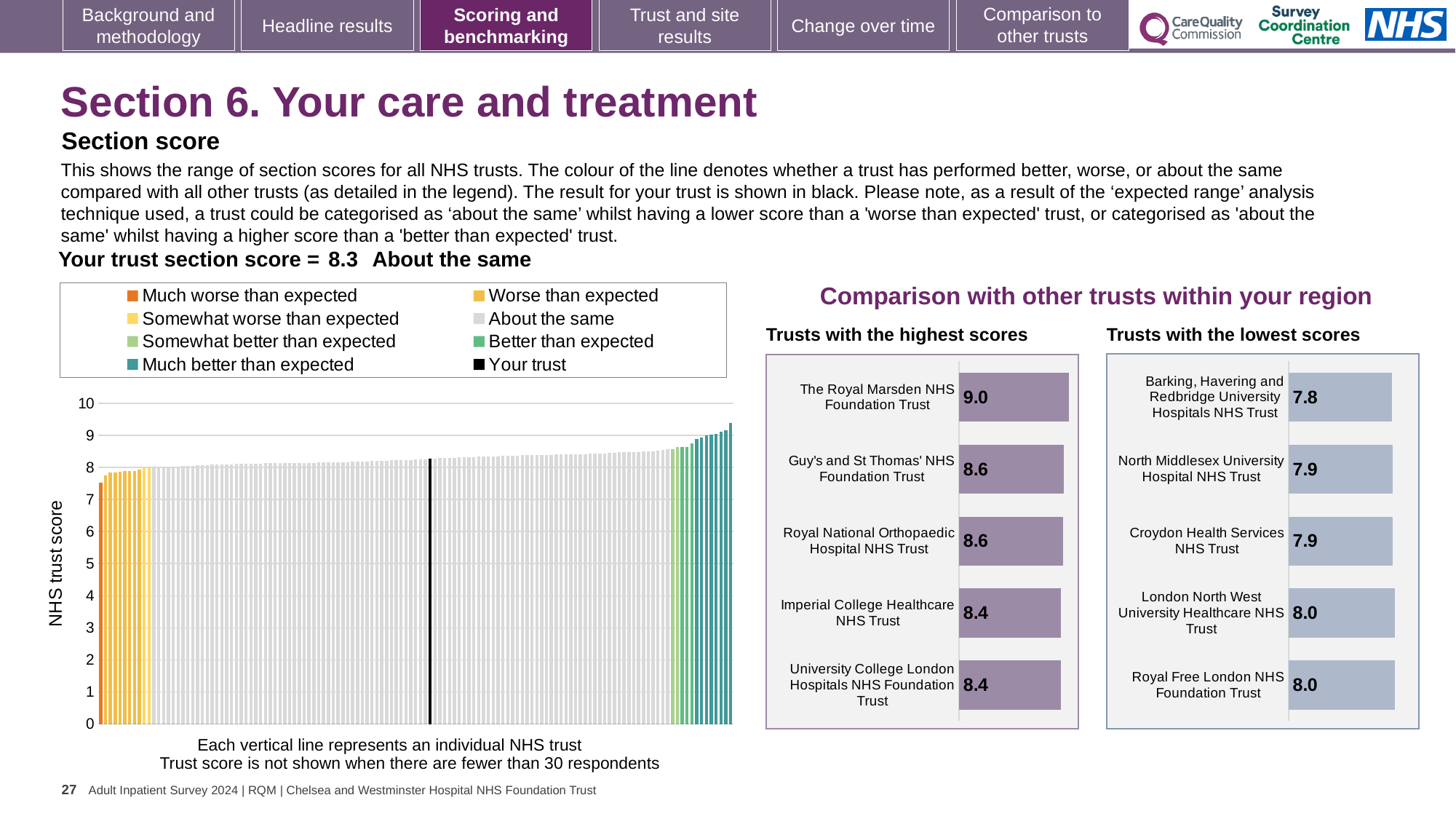
In the 'Trusts with the highest scores' chart, what is the difference between the scores of The Royal Marsden NHS Foundation Trust and Imperial College Healthcare NHS Trust? 0.6 In the large chart on the left showing all NHS trusts, how many entries does the legend list? 8 In the 'Trusts with the lowest scores' chart, what is the difference between the scores of Royal Free London NHS Foundation Trust and Barking, Havering and Redbridge University Hospitals NHS Trust? 0.2 In the 'Trusts with the lowest scores' chart, what is the score for Royal Free London NHS Foundation Trust? 8.0 Which is larger: the score for Guy's and St Thomas' NHS Foundation Trust in the highest scores chart, or the score for North Middlesex University Hospital NHS Trust in the lowest scores chart? Guy's and St Thomas' NHS Foundation Trust In the 'Trusts with the lowest scores' chart, which trust has the lowest score? Barking, Havering and Redbridge University Hospitals NHS Trust In the 'Trusts with the highest scores' chart, what is the score for Imperial College Healthcare NHS Trust? 8.4 In the 'Trusts with the highest scores' chart, which trust has the highest score? The Royal Marsden NHS Foundation Trust In the 'Trusts with the lowest scores' chart, what is the score for Barking, Havering and Redbridge University Hospitals NHS Trust? 7.8 In the 'Trusts with the highest scores' chart, what is the score for The Royal Marsden NHS Foundation Trust? 9.0 How many trusts are shown in the 'Trusts with the highest scores' chart? 5 In the large chart on the left showing all NHS trusts, is the value for the black 'Your trust' bar greater or less than 8? greater